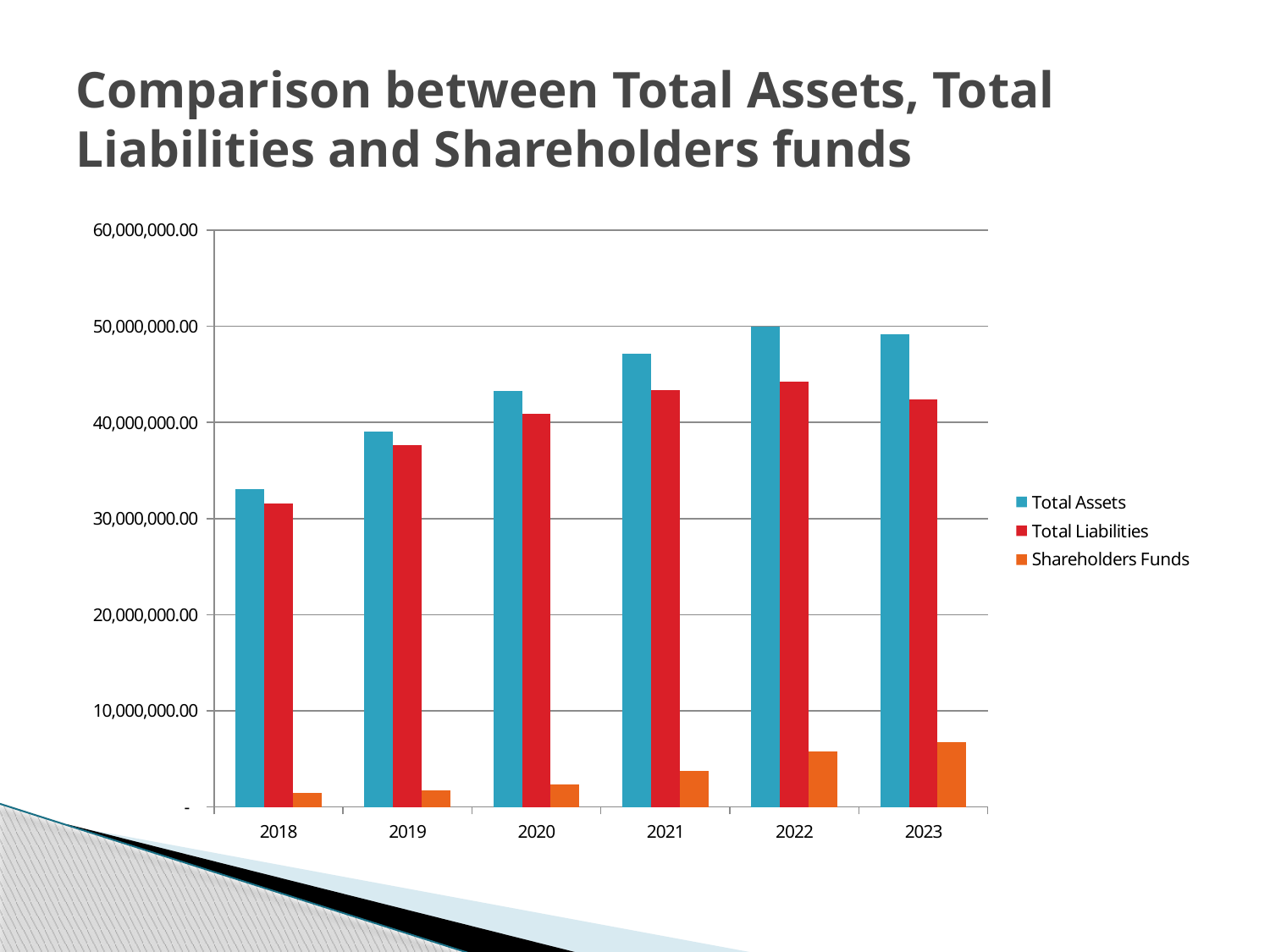
In which year is Total Assets lowest? 2018 How many series does the legend list? 3 In which year is Shareholders Funds highest? 2023 Is the value for Total Assets in 2018 greater or less than 30,000,000.00? greater In which year is Shareholders Funds lowest? 2018 What kind of chart is shown on the slide? Bar chart Is the value for Total Liabilities in 2019 greater or less than 40,000,000.00? less How many years are shown on the x axis? 6 In which year is Total Assets highest? 2022 In 2023, which is larger, Total Assets or Total Liabilities? Total Assets Is the value for Shareholders Funds in 2023 greater or less than 10,000,000.00? less Do the Shareholders Funds values rise or fall from 2018 to 2023? Rise